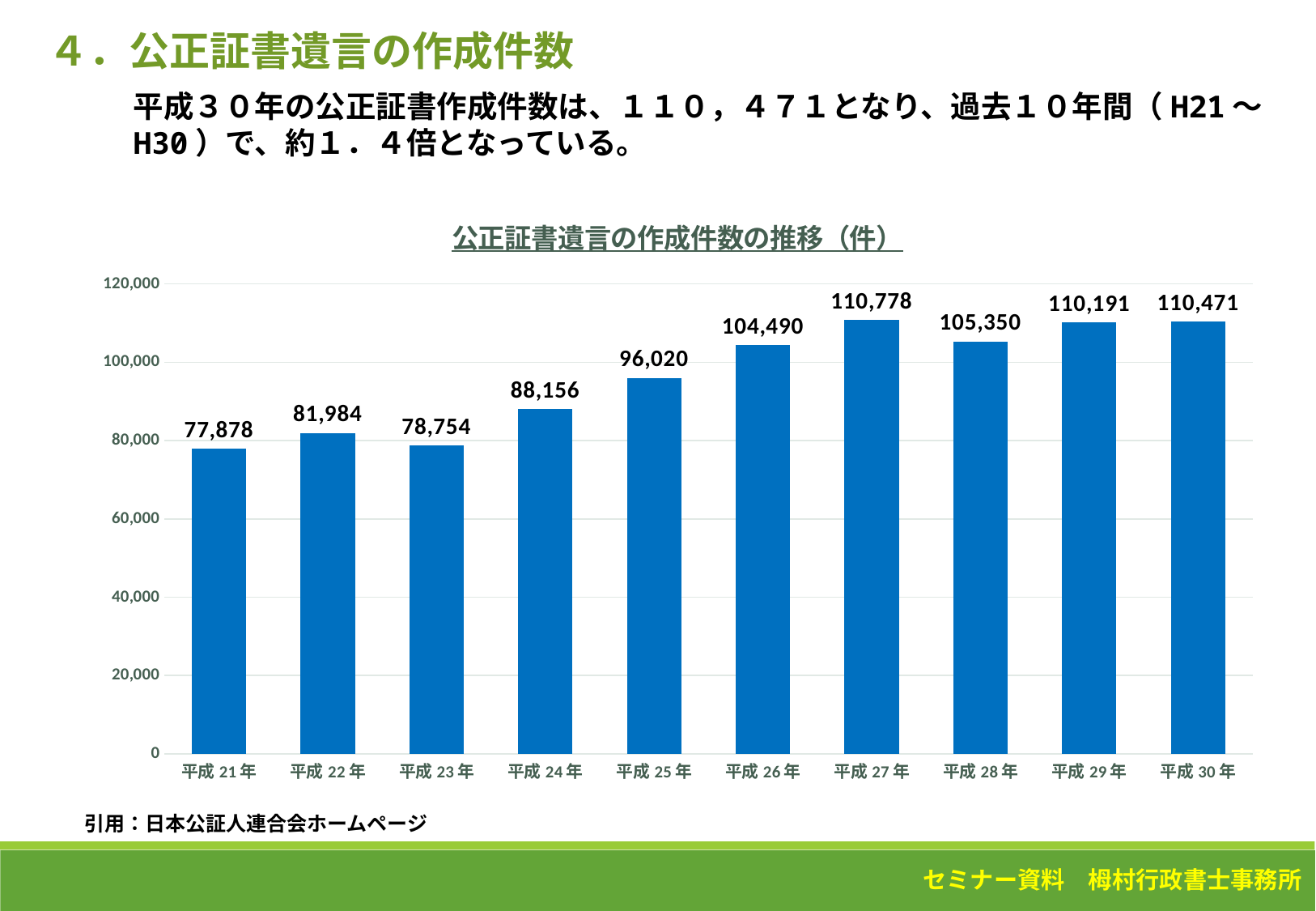
Do the values generally rise or fall from 平成21年 to 平成30年? rise What is the value for 平成21年? 77,878 What is the title of the chart? 公正証書遺言の作成件数の推移（件） Which is larger, the value for 平成22年 or the value for 平成23年? 平成22年 What is the value for 平成30年? 110,471 Which year has the lowest value? 平成21年 Is the value for 平成24年 greater or less than 100,000? less What is the value for 平成25年? 96,020 What kind of chart is shown on the slide? bar chart How many years are shown on the x axis? 10 Which year has the highest value? 平成27年 What is the difference between the values for 平成30年 and 平成21年? 32,593